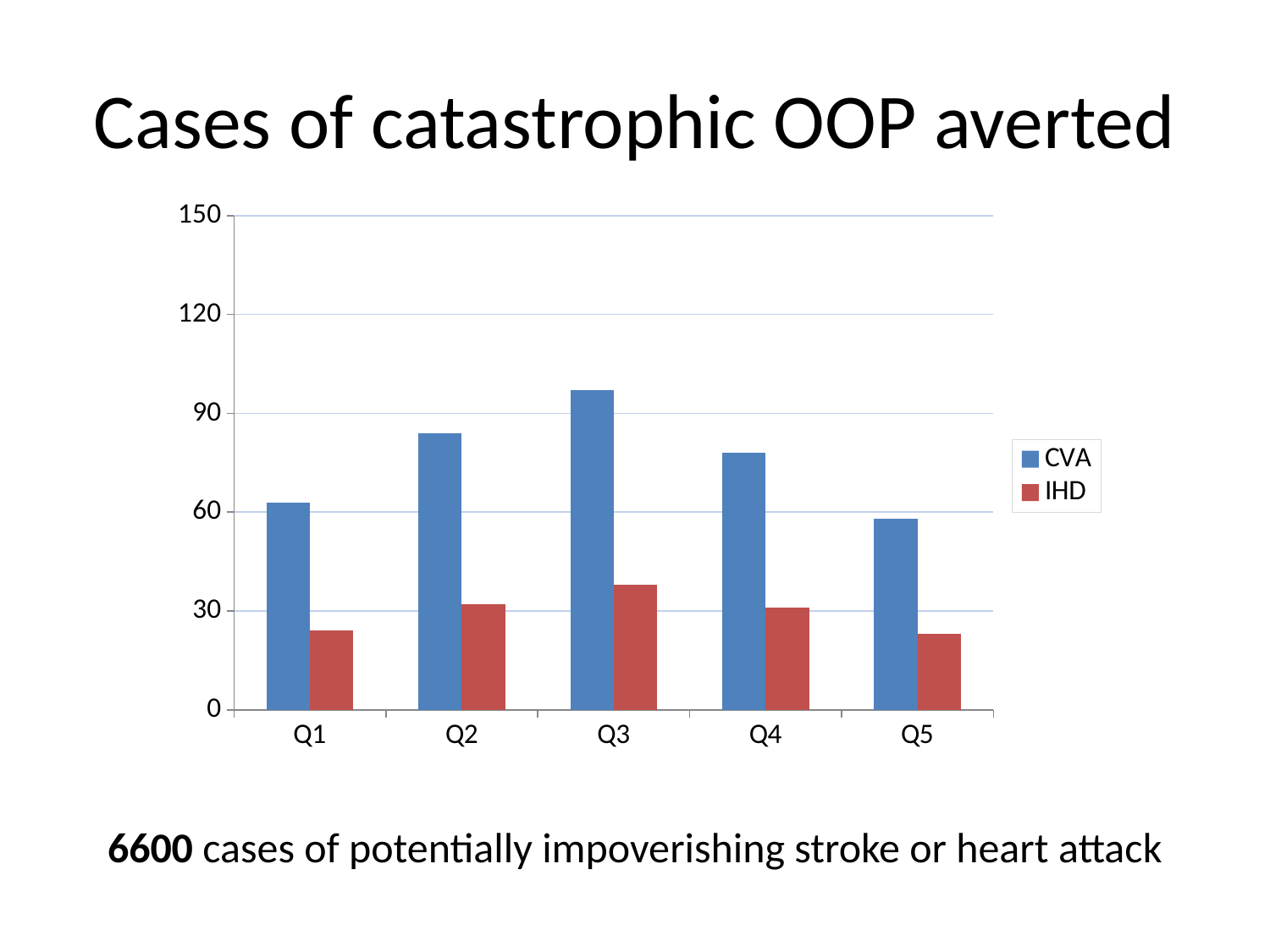
Is the IHD value for Q1 greater or less than 30? less How many series does the legend list? 2 Which category has the lowest CVA value? Q5 How many categories are shown on the x axis? 5 Is the IHD value for Q3 greater or less than 30? greater What kind of chart is shown on the slide? bar chart Which category has the highest IHD value? Q3 What is the title of the chart? Cases of catastrophic OOP averted Is the CVA value for Q3 greater or less than 90? greater Which is larger, the CVA value for Q2 or the CVA value for Q4? Q2 Which category has the highest CVA value? Q3